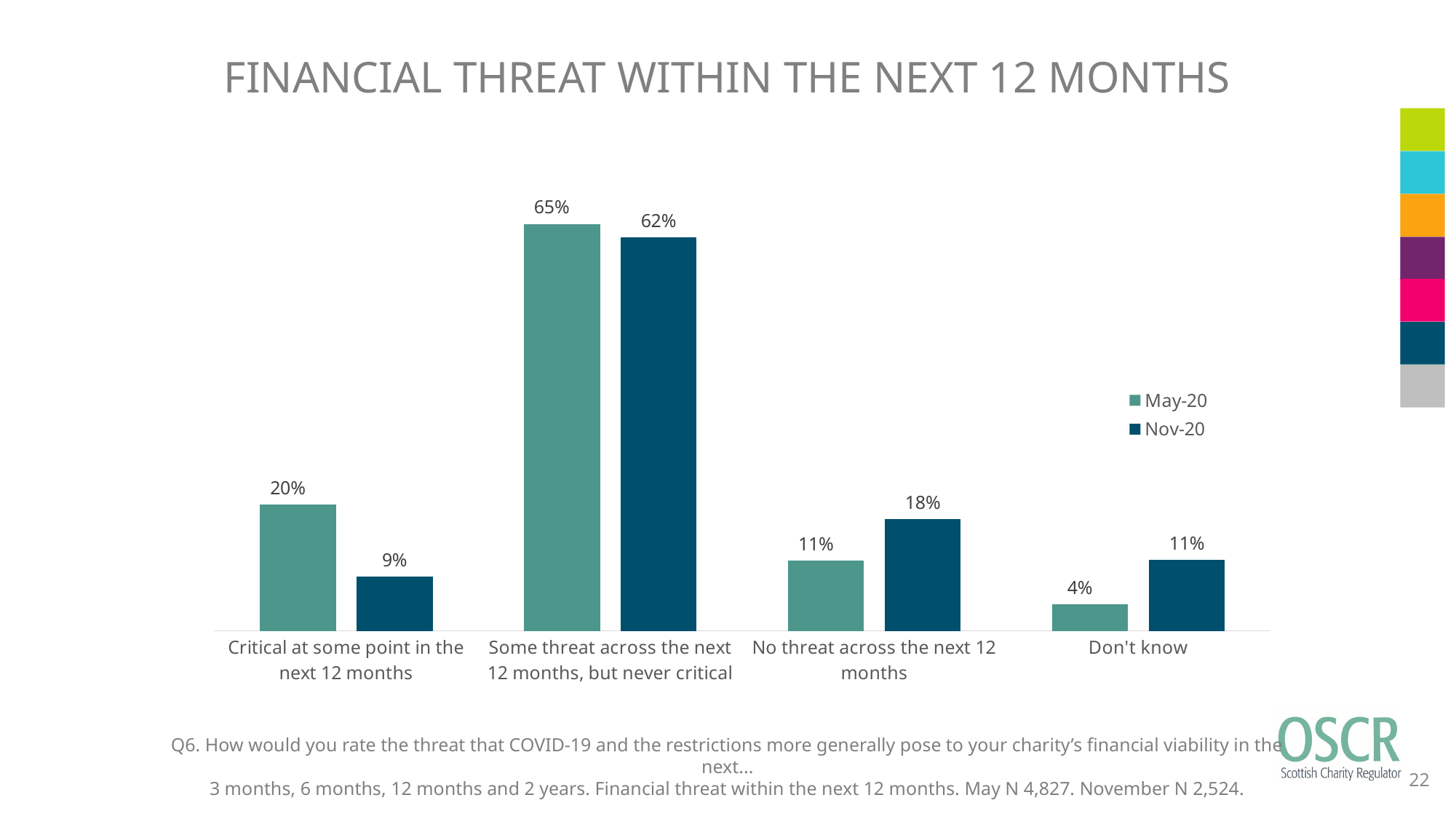
What is the title of the chart? FINANCIAL THREAT WITHIN THE NEXT 12 MONTHS How many categories are shown on the x axis? 4 What is the May-20 value for 'Don't know'? 4% What is the May-20 value for 'Some threat across the next 12 months, but never critical'? 65% What kind of chart is shown on the slide? Bar chart Which category has the lowest May-20 value? Don't know How many series does the legend list? 2 Which category has the highest Nov-20 value? Some threat across the next 12 months, but never critical For 'No threat across the next 12 months', which series has the larger value, May-20 or Nov-20? Nov-20 What is the difference between the May-20 and Nov-20 values for 'Critical at some point in the next 12 months'? 11% What is the Nov-20 value for 'Critical at some point in the next 12 months'? 9% What is the Nov-20 value for 'No threat across the next 12 months'? 18%